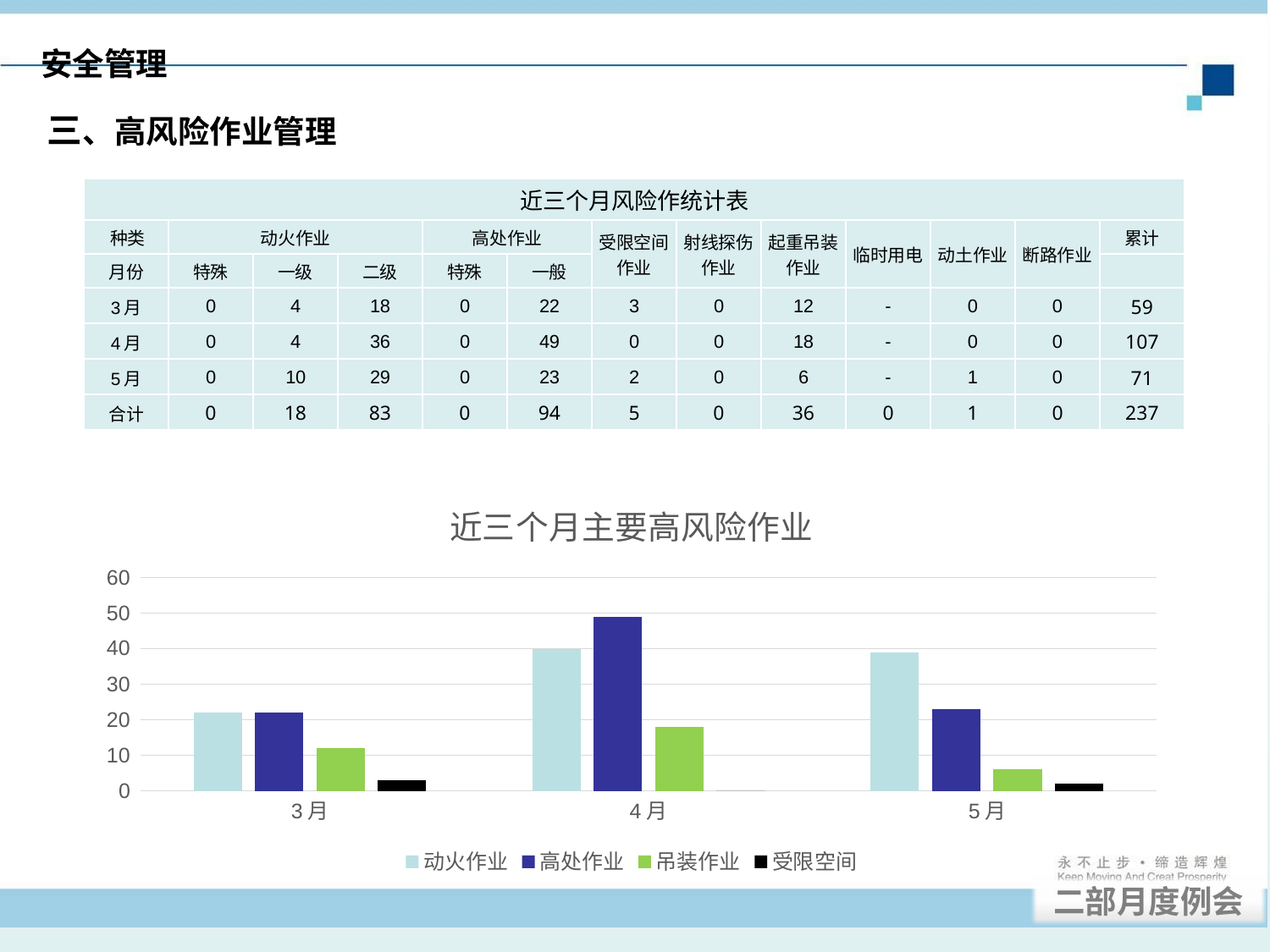
Which month has the lowest 吊装作业 bar? 5月 What is the title of the chart? 近三个月主要高风险作业 Which month has the highest 高处作业 bar? 4月 Is the 高处作业 value for 4月 greater or less than 40? greater How many months are shown on the x axis of the chart? 3 Is the 动火作业 value for 5月 greater or less than 30? greater Is the 吊装作业 value for 3月 greater or less than 10? greater What kind of chart is shown on the slide? bar chart Which colour represents 受限空间 in the chart legend? black How many series does the chart legend list? 4 Which is larger, the 动火作业 value for 4月 or for 3月? 4月